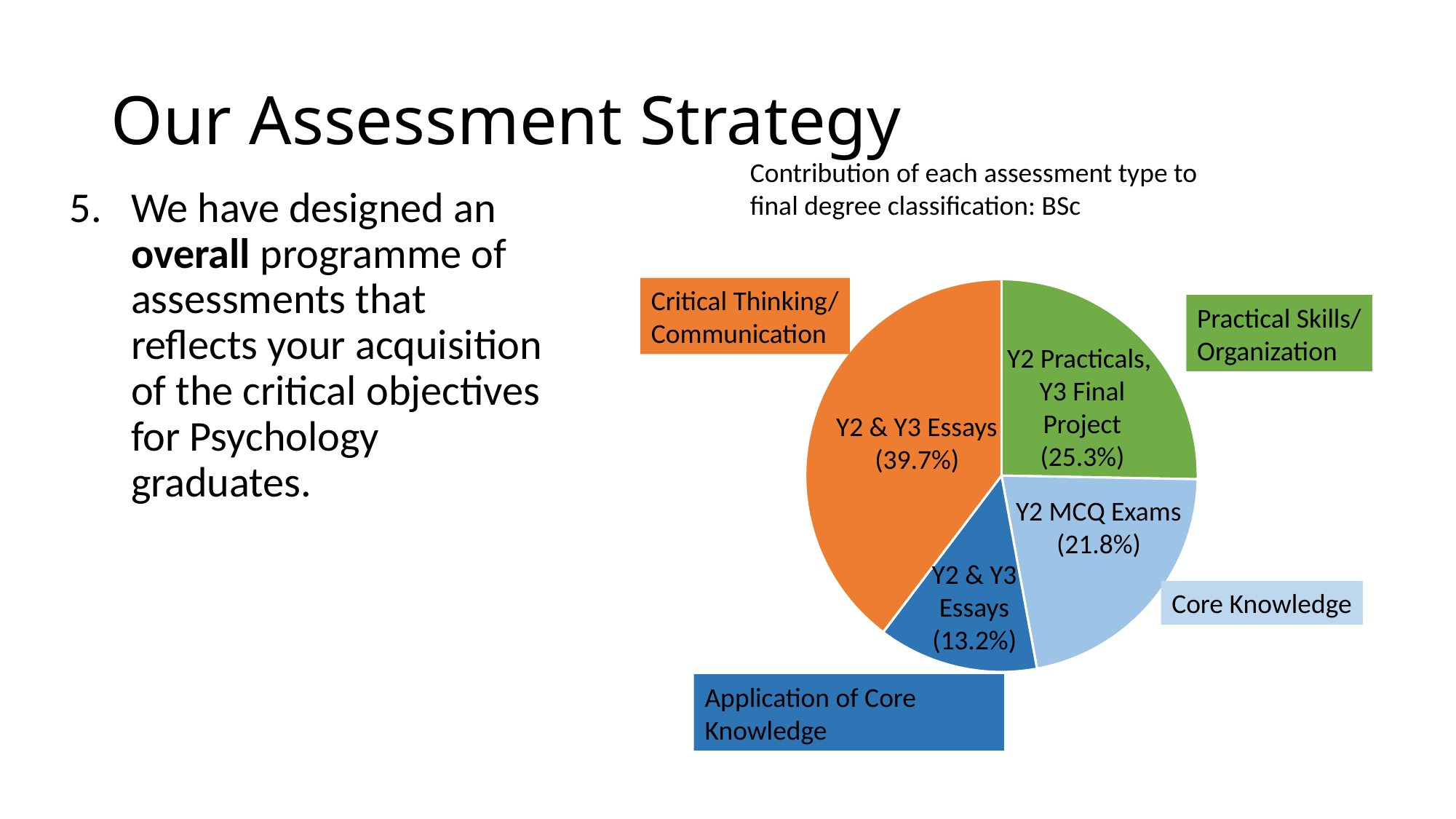
Which skill category is associated with the light blue slice (Y2 MCQ Exams)? Core Knowledge What is the title of the chart? Contribution of each assessment type to final degree classification: BSc What percentage is contributed by Y2 Practicals, Y3 Final Project? 25.3% How many slices does the pie chart have? 4 What percentage is contributed by the Y2 & Y3 Essays slice labelled Application of Core Knowledge? 13.2% What percentage is contributed by the Y2 & Y3 Essays slice labelled Critical Thinking/Communication? 39.7% Which slice of the pie chart is the largest? Y2 & Y3 Essays (39.7%) What is the difference in percentage points between Y2 Practicals, Y3 Final Project and Y2 MCQ Exams? 3.5 What kind of chart is shown on the slide? Pie chart What percentage of the final degree classification comes from Y2 MCQ Exams? 21.8% Which contributes more to the final degree classification: Y2 MCQ Exams or Y2 Practicals, Y3 Final Project? Y2 Practicals, Y3 Final Project Which slice of the pie chart is the smallest? Y2 & Y3 Essays (13.2%)